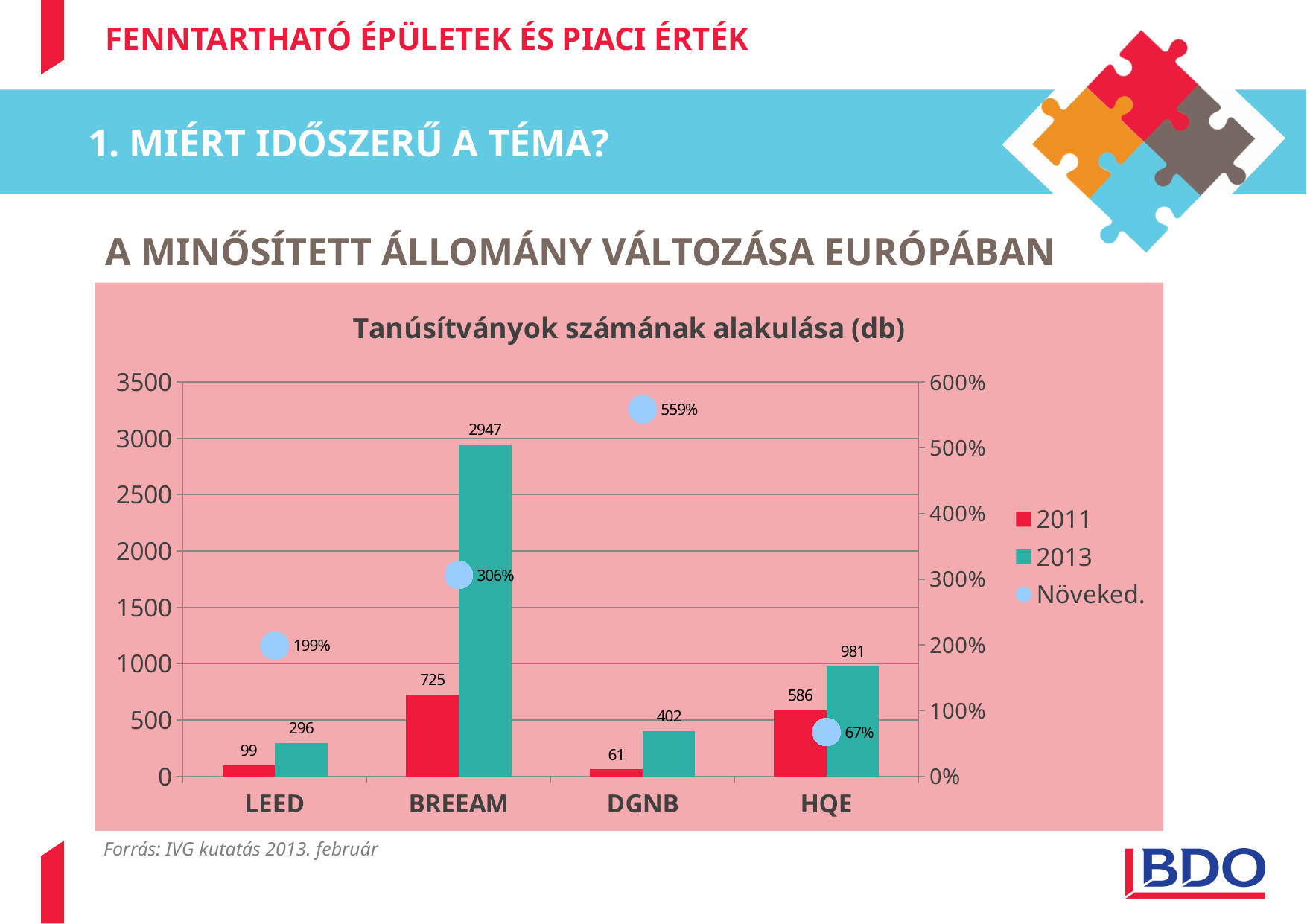
What is the 2013 value for HQE? 981 Which category has the lowest 2011 value? DGNB Which category has the lowest growth percentage (Növeked.)? HQE What is the 2011 value for DGNB? 61 What is the 2013 value for BREEAM? 2947 How many categories are shown on the x axis? 4 What growth percentage (Növeked.) is shown for DGNB? 559% What is the title of the chart? Tanúsítványok számának alakulása (db) Which is larger, the 2011 value for HQE or the 2013 value for DGNB? 2011 value for HQE How many series does the legend list? 3 What is the difference between the 2013 and 2011 values for LEED? 197 Which category has the highest 2013 value? BREEAM